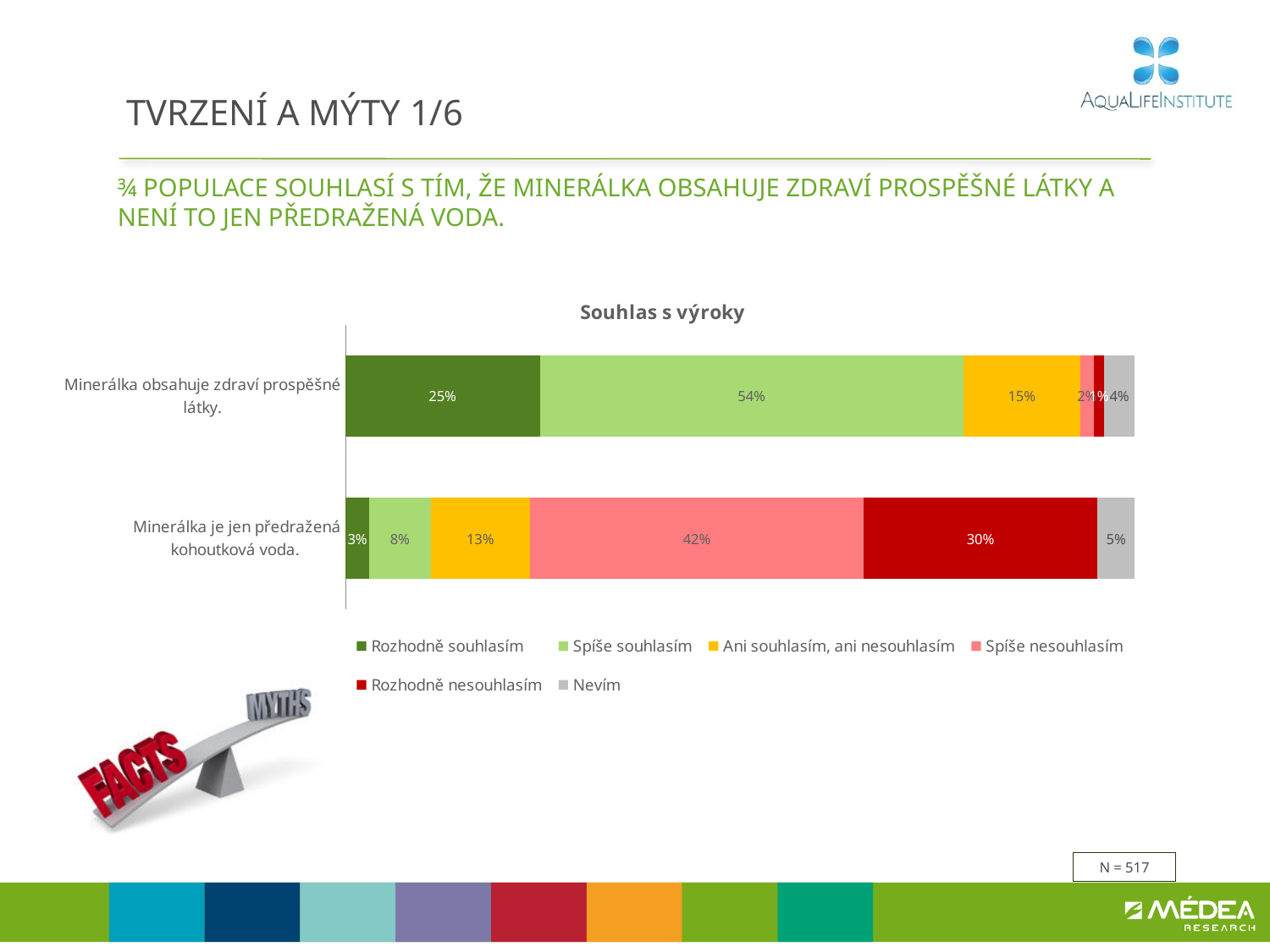
What kind of chart is shown on the slide? stacked bar chart What is the value of 'Rozhodně nesouhlasím' for 'Minerálka je jen předražená kohoutková voda.'? 30% Which is larger for 'Minerálka je jen předražená kohoutková voda.': 'Spíše souhlasím' or 'Ani souhlasím, ani nesouhlasím'? Ani souhlasím, ani nesouhlasím How many series does the legend list? 6 Which response has the largest share for 'Minerálka je jen předražená kohoutková voda.'? Spíše nesouhlasím What is the difference between 'Spíše souhlasím' and 'Ani souhlasím, ani nesouhlasím' for 'Minerálka obsahuje zdraví prospěšné látky.'? 39% How many statements (categories) are plotted in the chart? 2 What is the value of 'Spíše souhlasím' for 'Minerálka obsahuje zdraví prospěšné látky.'? 54% What is the value of 'Rozhodně souhlasím' for 'Minerálka obsahuje zdraví prospěšné látky.'? 25% What is the value of 'Nevím' for 'Minerálka je jen předražená kohoutková voda.'? 5% What is the value of 'Spíše nesouhlasím' for 'Minerálka je jen předražená kohoutková voda.'? 42% What is the title of the chart? Souhlas s výroky